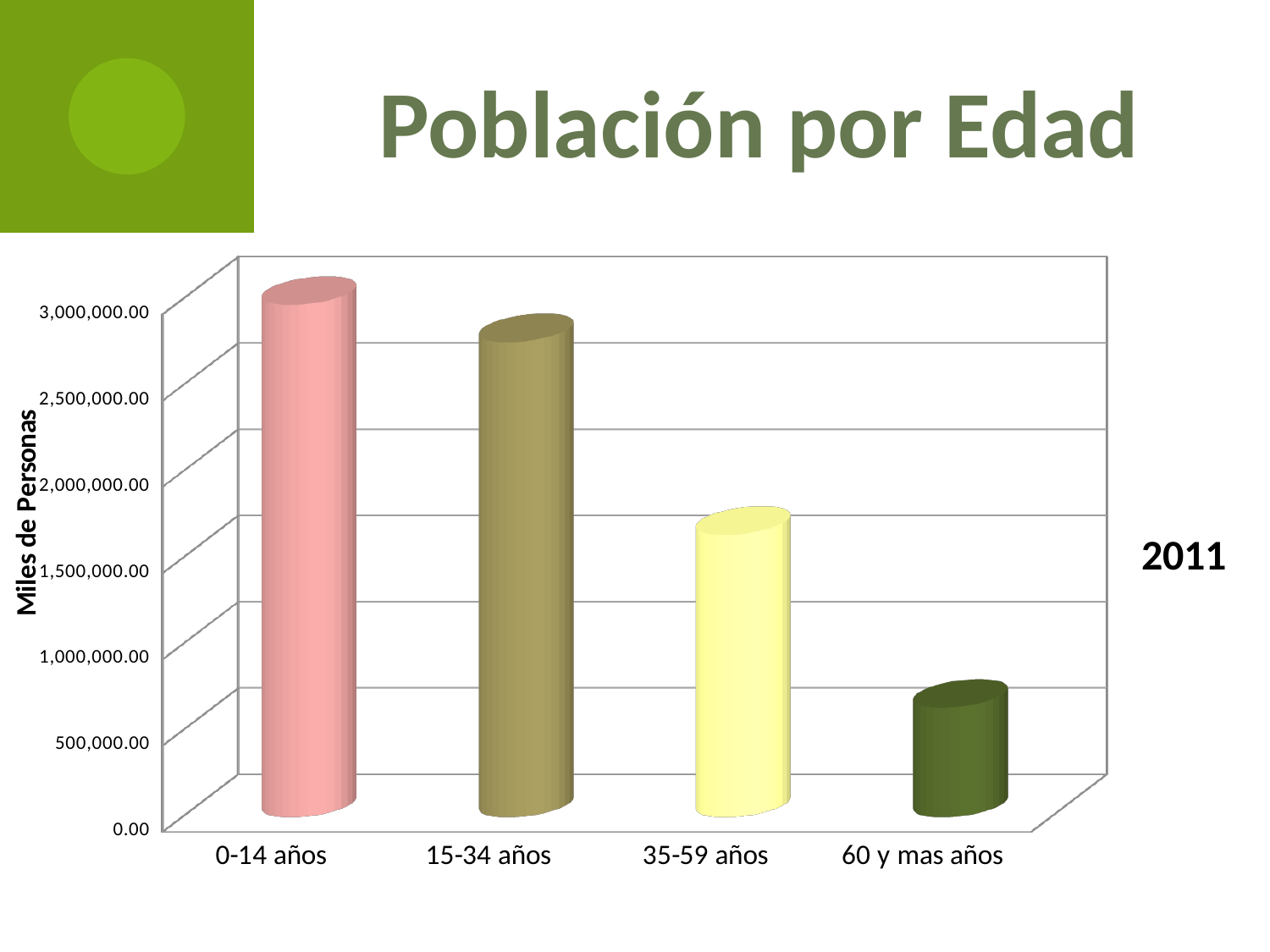
What is the label on the vertical axis? Miles de Personas Which age category has the lowest value? 60 y mas años Which age category has the highest value? 0-14 años How many age categories are shown on the x axis? 4 Is the value for 15-34 años greater or less than 2,500,000.00? greater What kind of chart is shown on the slide? bar chart Do the values rise or fall as you move from 0-14 años to 60 y mas años along the x axis? fall Is the value for 35-59 años greater or less than 2,000,000.00? less Is the value for 60 y mas años greater or less than 1,000,000.00? less Which is larger, the value for 15-34 años or the value for 35-59 años? 15-34 años